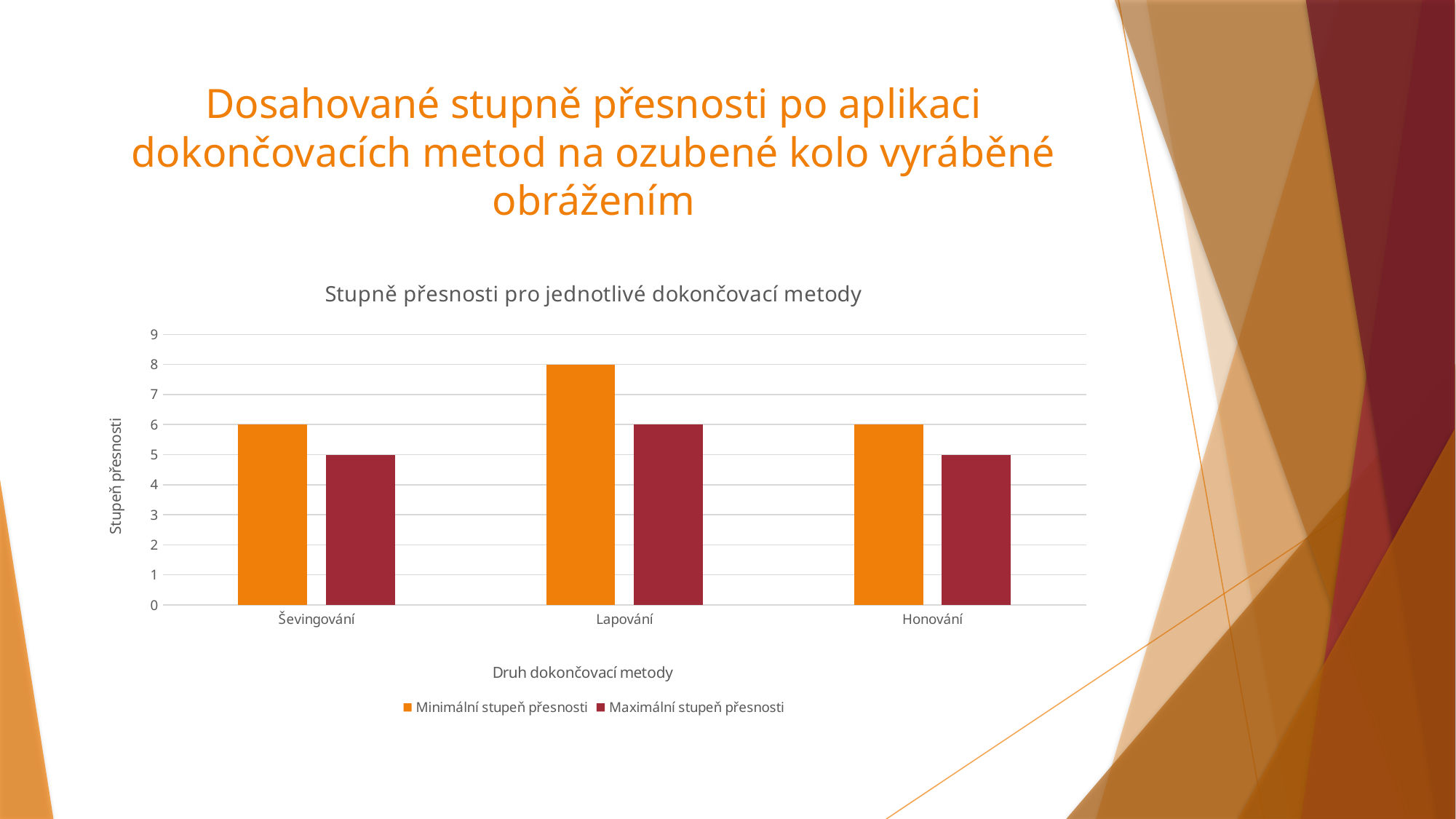
What is the value of Minimální stupeň přesnosti for Lapování? 8 What type of chart is shown on the slide? bar chart Which is larger for Ševingování: Minimální stupeň přesnosti or Maximální stupeň přesnosti? Minimální stupeň přesnosti What is the value of Maximální stupeň přesnosti for Ševingování? 5 What is the difference between Minimální stupeň přesnosti and Maximální stupeň přesnosti for Lapování? 2 What is the label of the x axis? Druh dokončovací metody What is the title of the chart? Stupně přesnosti pro jednotlivé dokončovací metody How many series does the legend list? 2 Which category has the highest Maximální stupeň přesnosti? Lapování How many finishing methods (categories) are shown on the x axis? 3 What is the value of Minimální stupeň přesnosti for Honování? 6 Which category has the highest Minimální stupeň přesnosti? Lapování